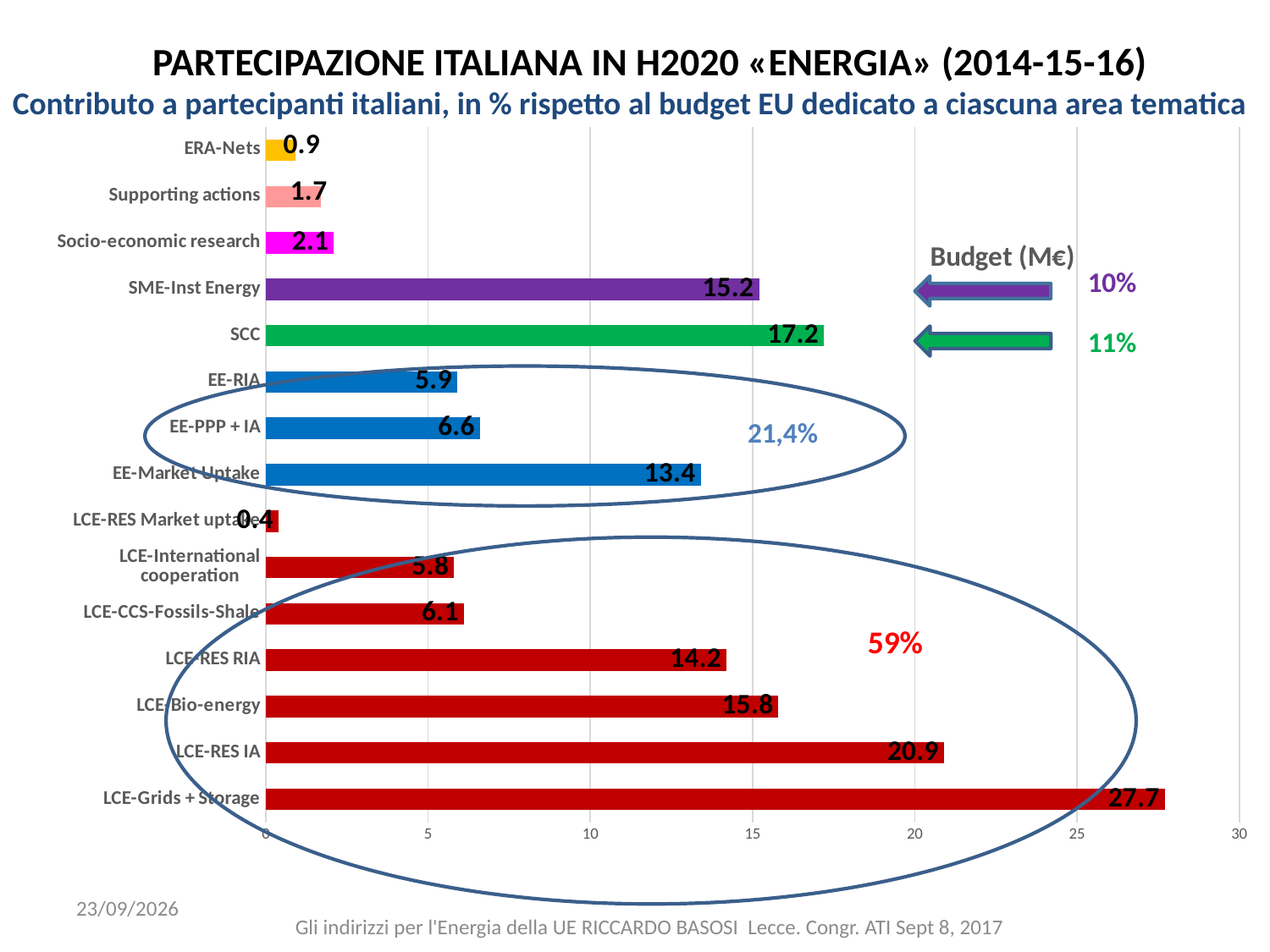
What is the value for SCC? 17.2 What is the difference between the values for LCE-RES IA and LCE-RES RIA? 6.7 Which category has the highest value? LCE-Grids + Storage Which category has the lowest value? LCE-RES Market uptake Is the value for LCE-RES IA greater or less than 20? greater What is the value for LCE-Grids + Storage? 27.7 What is the maximum value shown on the horizontal axis? 30 How many categories are plotted in the chart? 15 What is the value for Supporting actions? 1.7 What is the value for EE-Market Uptake? 13.4 Which is larger, the value for SME-Inst Energy or the value for LCE-Bio-energy? LCE-Bio-energy What kind of chart is shown on the slide? bar chart